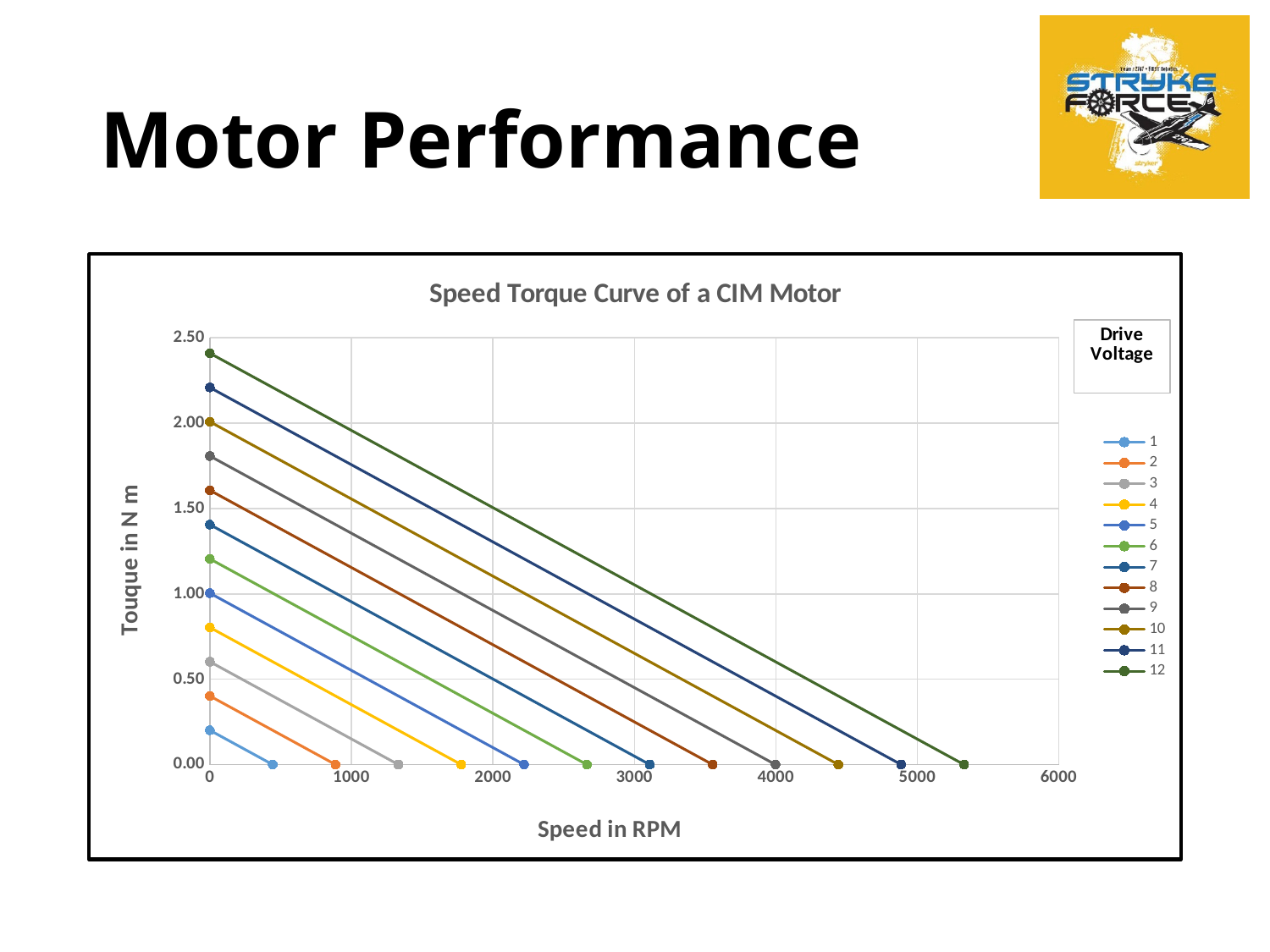
Which drive voltage series has the highest torque at 0 RPM? 12 How many series does the legend list? 12 For each drive voltage series, does torque rise or fall as speed increases? fall What is the torque at 0 RPM for drive voltage 10? 2.00 Is the speed at which the drive voltage 12 line reaches zero torque greater or less than 5000 RPM? greater Is the torque at 0 RPM for drive voltage 12 greater or less than 2.00? greater What is the torque at 0 RPM for drive voltage 5? 1.00 What kind of chart is shown on the slide? line chart What is the title of the chart? Speed Torque Curve of a CIM Motor Which drive voltage series has the lowest torque at 0 RPM? 1 Is the speed at which the drive voltage 1 line reaches zero torque greater or less than 1000 RPM? less What is the title of the legend? Drive Voltage